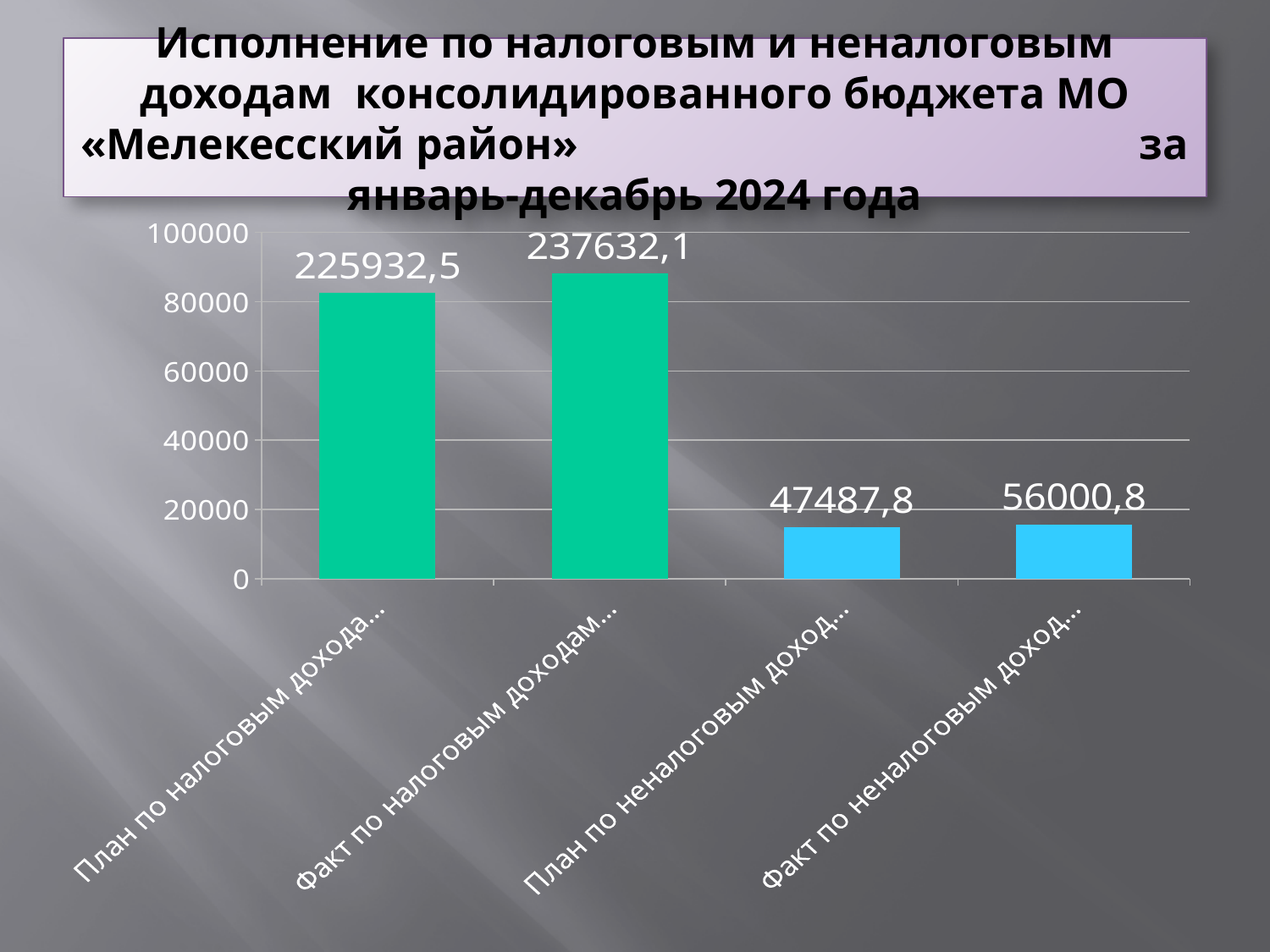
What is the value shown for the bar labelled "Факт по неналоговым доход..."? 56000,8 What is the difference between the value for "Факт по неналоговым доходам" and the value for "План по неналоговым доходам"? 8513 What period does the chart title say the data covers? январь-декабрь 2024 года What kind of chart is shown on the slide? Bar chart Which bar has the lowest value? План по неналоговым доходам How many bars are plotted in the chart? 4 Which bar has the highest value? Факт по налоговым доходам Which is larger: the value for "План по неналоговым доходам" or the value for "Факт по неналоговым доходам"? Факт по неналоговым доходам What is the value shown for the bar labelled "План по налоговым дохода..."? 225932,5 What is the value shown for the bar labelled "План по неналоговым доход..."? 47487,8 What is the value shown for the bar labelled "Факт по налоговым доходам..."? 237632,1 What is the difference between the value for "Факт по налоговым доходам" and the value for "План по налоговым доходам"? 11699,6